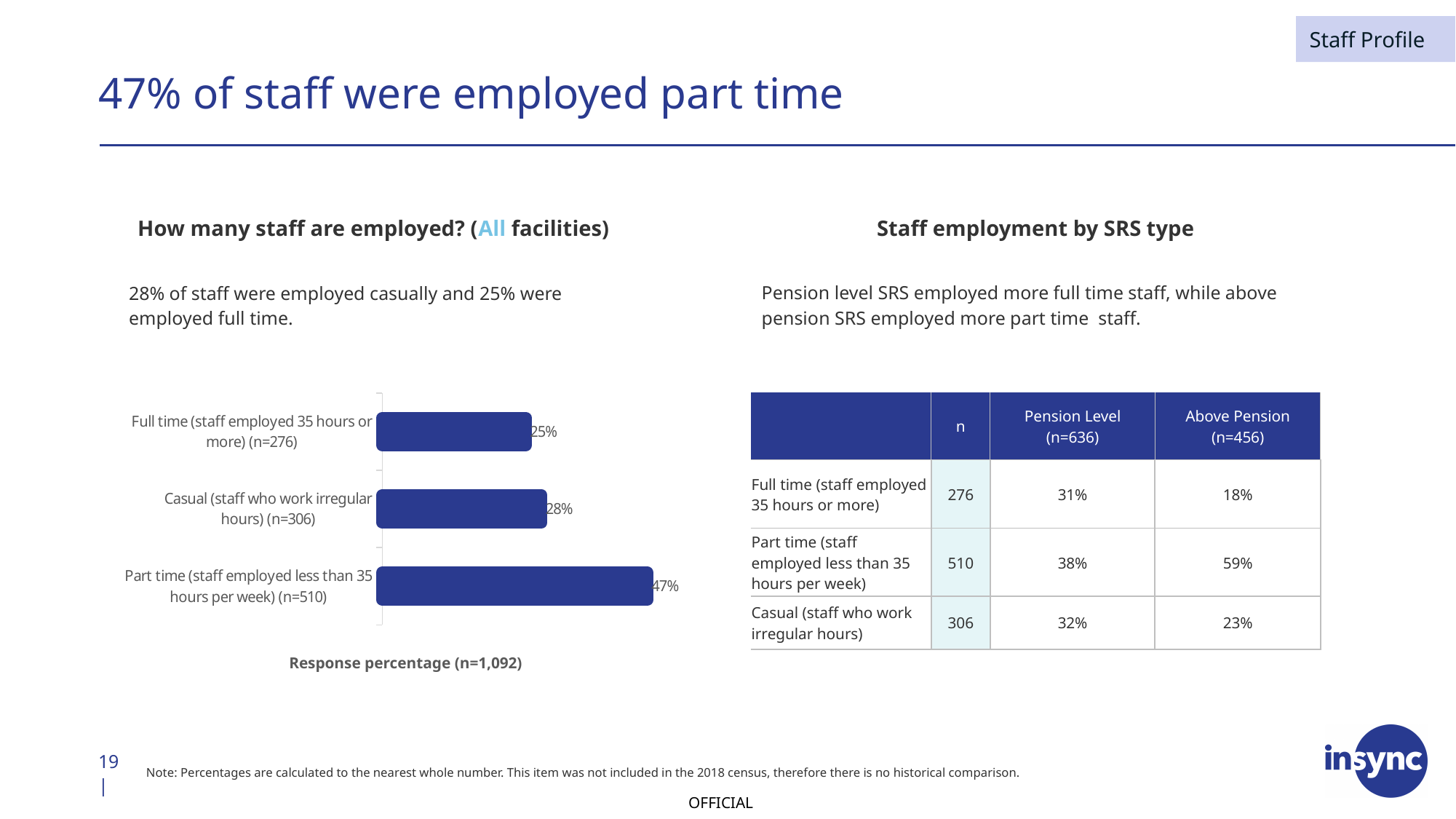
What type of chart is shown on the slide? Bar chart What is the response percentage for Casual (staff who work irregular hours)? 28% What is the x-axis label of the bar chart? Response percentage (n=1,092) What is the difference in response percentage between Casual and Full time staff? 3% Which employment category has the lowest response percentage? Full time (staff employed 35 hours or more) Which employment category has the highest response percentage? Part time (staff employed less than 35 hours per week) What is the response percentage for Full time (staff employed 35 hours or more)? 25% What is the difference in response percentage between Part time and Full time staff? 22% How many employment categories are shown in the bar chart? 3 Which has a higher response percentage, Casual or Full time? Casual What is the n value shown for the Part time category in the bar chart? 510 What is the response percentage for Part time (staff employed less than 35 hours per week)? 47%